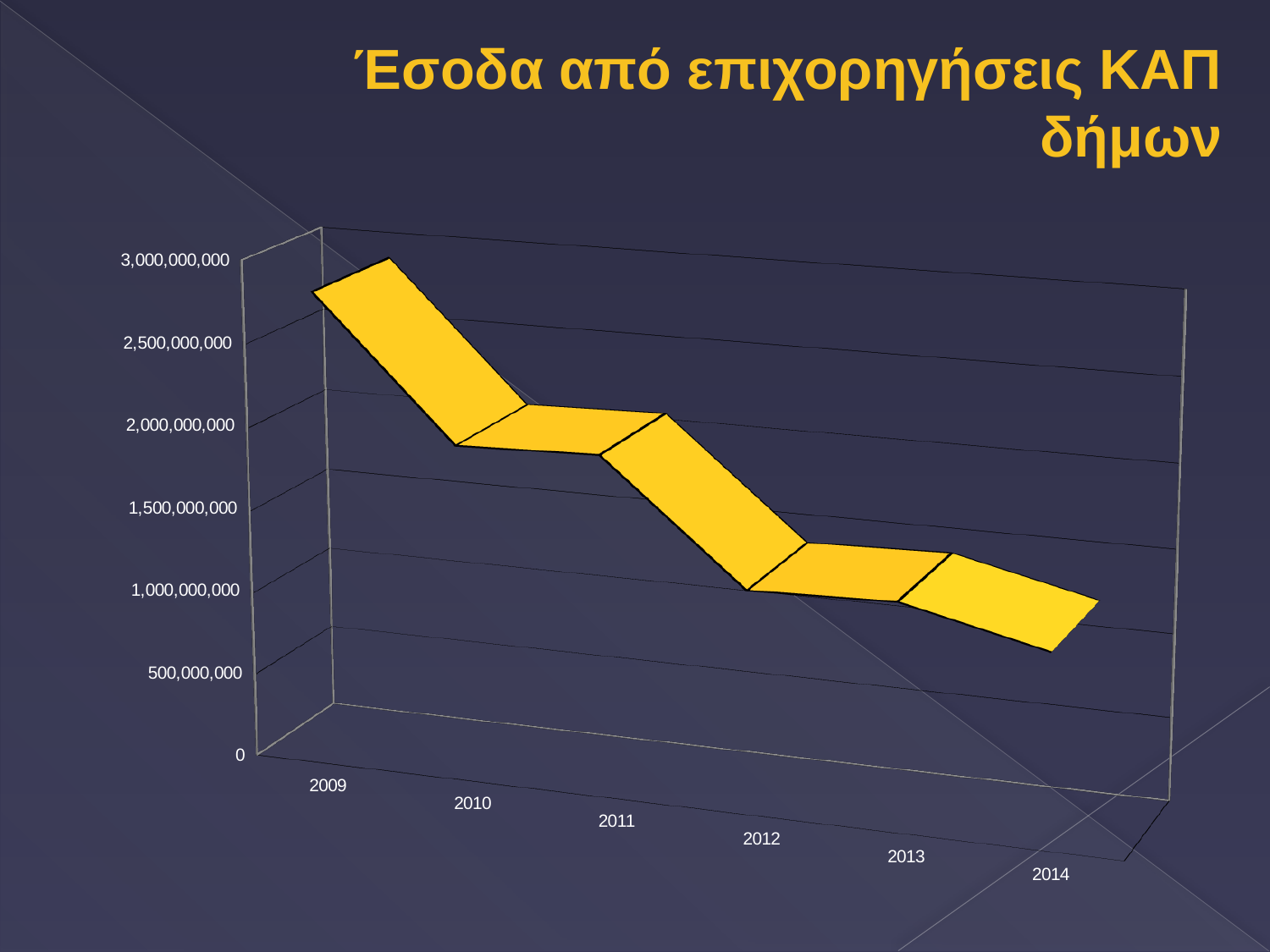
Is the value for 2014 greater or less than 1,500,000,000? less Which is larger, the value for 2011 or the value for 2012? 2011 Which year has the lowest value? 2014 Is the value for 2009 greater or less than 2,500,000,000? greater Which year has the highest value? 2009 What kind of chart is shown on the slide? line chart Is the value for 2011 greater or less than 1,500,000,000? greater What is the title of the chart? Έσοδα από επιχορηγήσεις ΚΑΠ δήμων How many years are plotted on the x axis? 6 Which is larger, the value for 2009 or the value for 2014? 2009 Do the values rise or fall from 2009 to 2014? fall